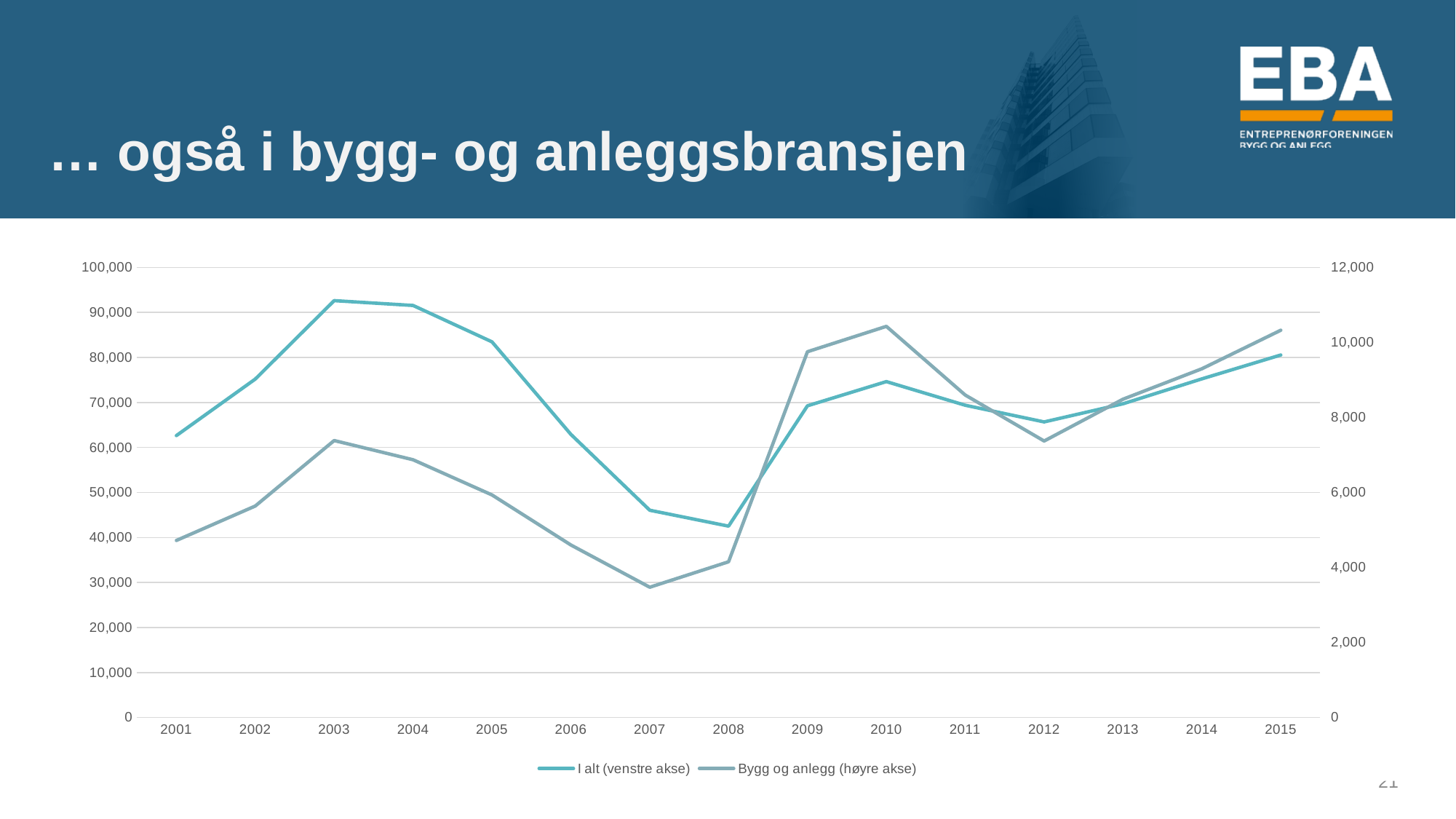
In which year is the 'I alt (venstre akse)' series at its lowest? 2008 Is the value for 'Bygg og anlegg (høyre akse)' in 2007 greater or less than 4,000? less Which series is plotted against the right-hand axis according to the legend? Bygg og anlegg (høyre akse) What kind of chart is shown on the slide? line chart How many series does the legend list? 2 Which year has the larger value for 'Bygg og anlegg (høyre akse)', 2010 or 2012? 2010 Is the value for 'I alt (venstre akse)' in 2003 greater or less than 90,000? greater How many years are plotted along the x axis? 15 Is the value for 'Bygg og anlegg (høyre akse)' in 2009 greater or less than 8,000? greater In which year is the 'Bygg og anlegg (høyre akse)' series at its lowest? 2007 Does the 'I alt (venstre akse)' series rise or fall from 2005 to 2008? fall